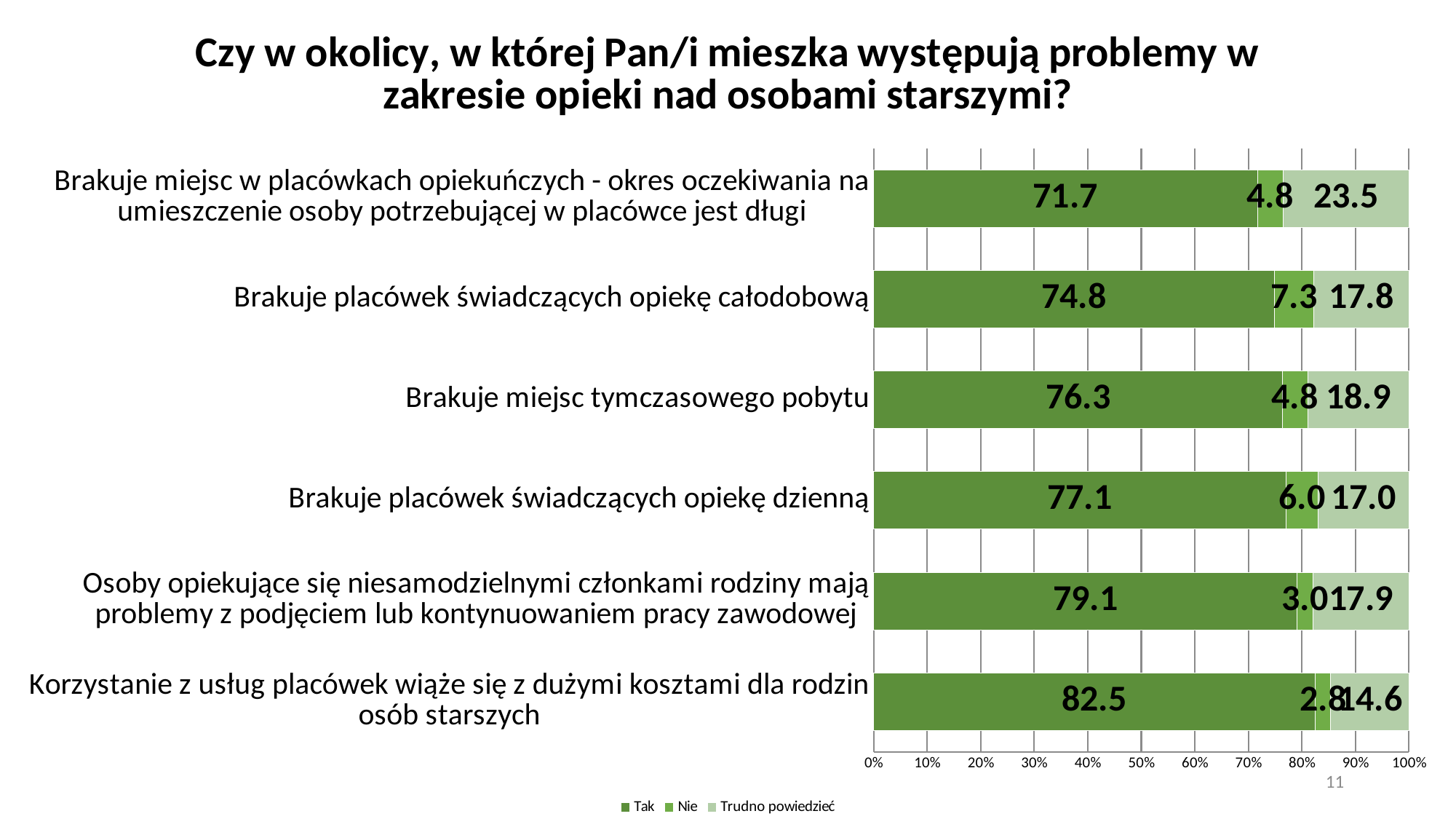
How many series does the legend list? 3 What kind of chart is shown on the slide? stacked bar chart Which statement has the lowest 'Tak' value? Brakuje miejsc w placówkach opiekuńczych - okres oczekiwania na umieszczenie osoby potrzebującej w placówce jest długi What is the 'Tak' value for 'Brakuje miejsc tymczasowego pobytu'? 76.3 Which is larger: the 'Nie' value for 'Brakuje placówek świadczących opiekę całodobową' or the 'Nie' value for 'Brakuje miejsc tymczasowego pobytu'? Brakuje placówek świadczących opiekę całodobową Is the 'Tak' value for 'Osoby opiekujące się niesamodzielnymi członkami rodziny mają problemy z podjęciem lub kontynuowaniem pracy zawodowej' greater or less than 70%? greater What is the difference between the 'Tak' values for 'Korzystanie z usług placówek wiąże się z dużymi kosztami dla rodzin osób starszych' and 'Brakuje miejsc w placówkach opiekuńczych - okres oczekiwania na umieszczenie osoby potrzebującej w placówce jest długi'? 10.8 Which legend entry is shown in the darkest green? Tak Which statement has the highest 'Tak' value? Korzystanie z usług placówek wiąże się z dużymi kosztami dla rodzin osób starszych How many categories (statements) are plotted on the chart? 6 What is the 'Trudno powiedzieć' value for 'Brakuje placówek świadczących opiekę całodobową'? 17.8 What is the 'Nie' value for 'Brakuje placówek świadczących opiekę dzienną'? 6.0